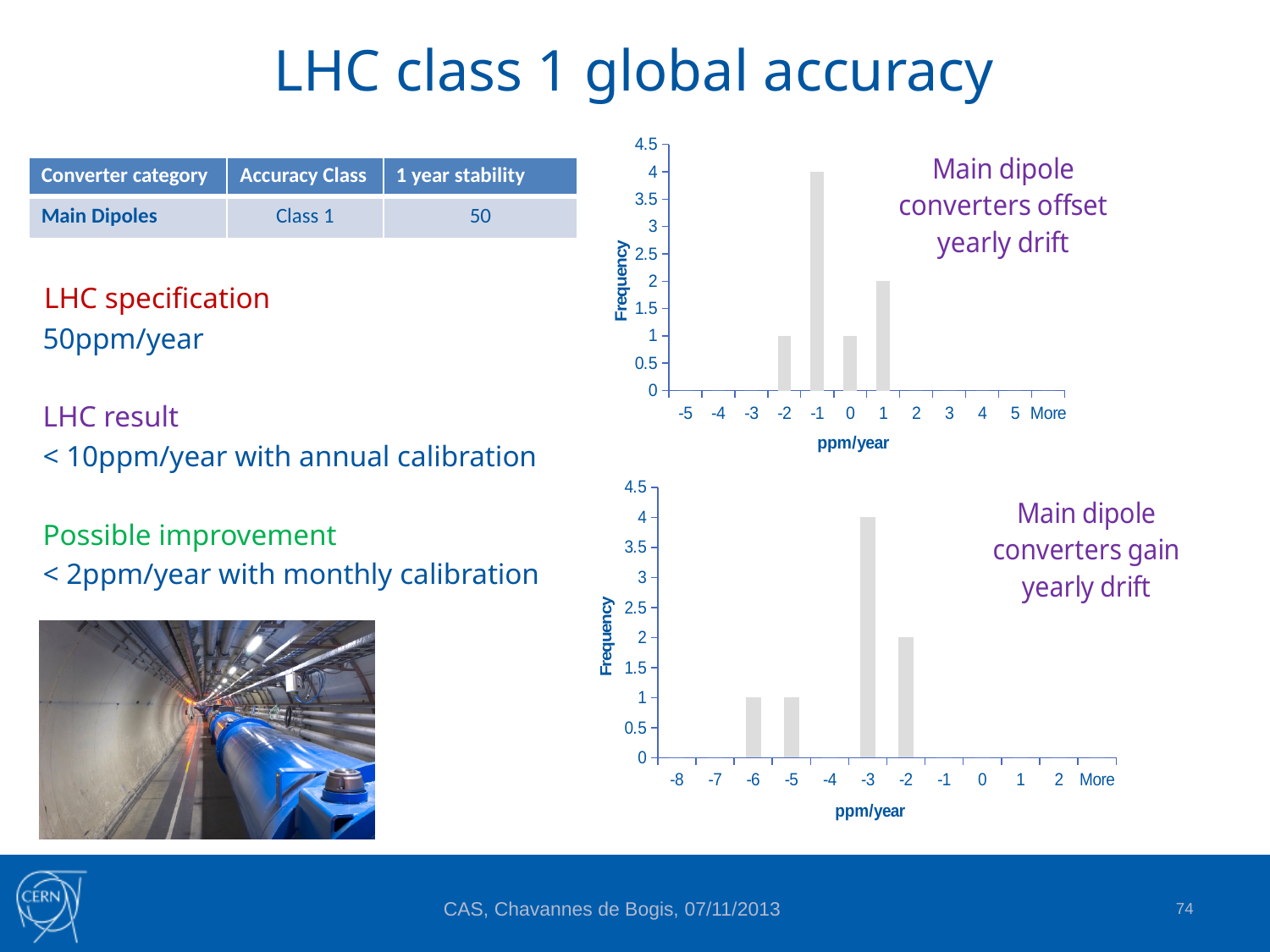
In the 'Main dipole converters offset yearly drift' chart, what is the frequency for the 1 ppm/year bin? 2 In the 'Main dipole converters gain yearly drift' chart, is the frequency for the -3 bin greater or less than 3? greater In the 'Main dipole converters offset yearly drift' chart, what is the difference in frequency between the -1 bin and the 1 bin? 2 In the 'Main dipole converters offset yearly drift' chart, which ppm/year bin has the highest frequency? -1 In the 'Main dipole converters gain yearly drift' chart, what is the frequency for the -3 ppm/year bin? 4 In the 'Main dipole converters offset yearly drift' chart, what is the frequency for the -1 ppm/year bin? 4 In the 'Main dipole converters gain yearly drift' chart, which bin has the larger frequency, -2 or -5? -2 In the 'Main dipole converters offset yearly drift' chart, how many bins are shown on the x axis? 12 What kind of chart is the 'Main dipole converters gain yearly drift' chart? Bar chart In the 'Main dipole converters gain yearly drift' chart, what is the frequency for the -6 ppm/year bin? 1 What is the y-axis label of the 'Main dipole converters offset yearly drift' chart? Frequency In the 'Main dipole converters gain yearly drift' chart, which ppm/year bin has the highest frequency? -3